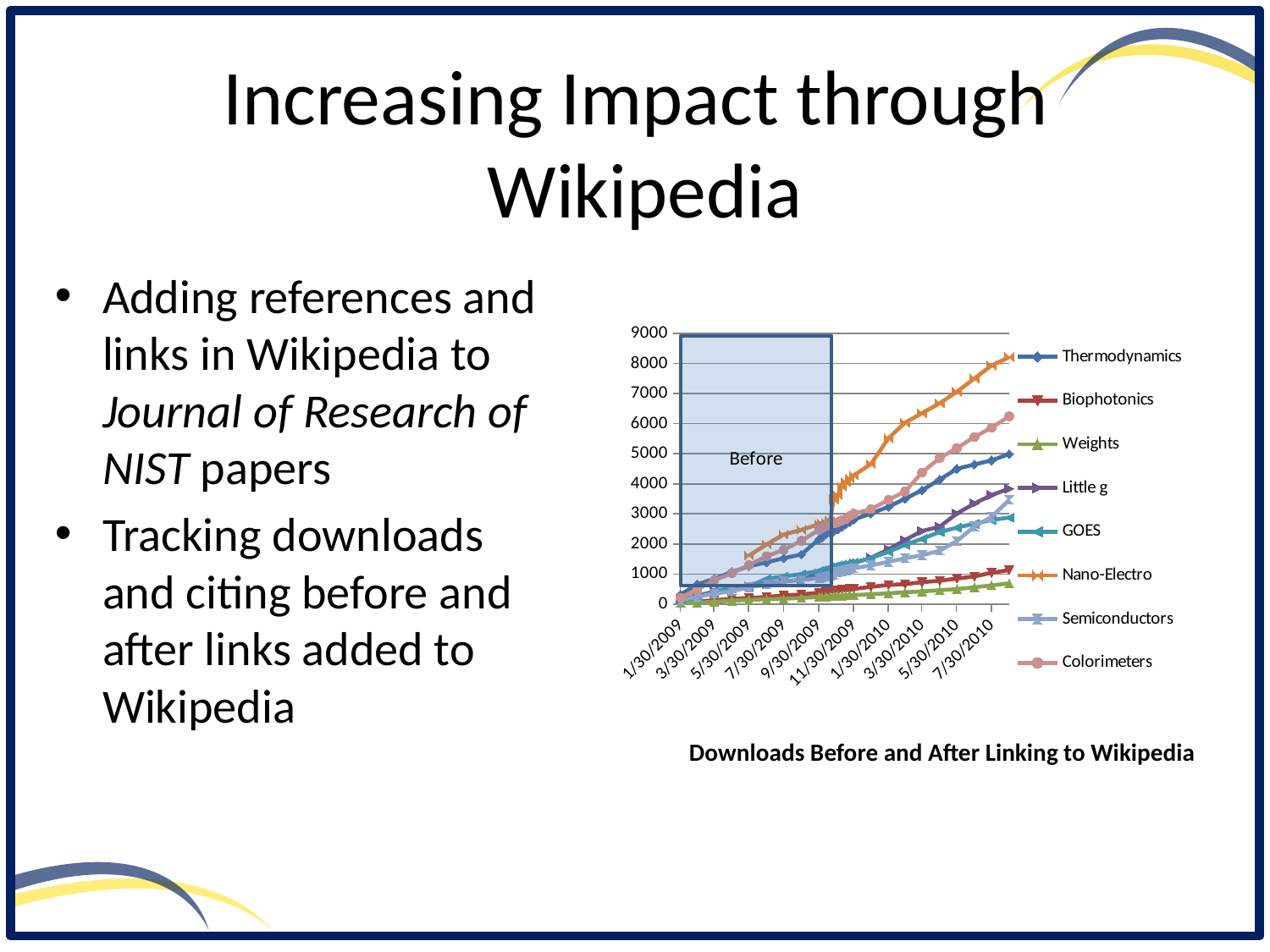
How many series does the chart legend list? 8 What kind of chart is shown on the slide? Line chart Which series has the highest value at the end of the period (7/30/2010)? Nano-Electro What label is shown inside the shaded region on the left of the chart? Before Is the final value for Nano-Electro greater or less than 8000? greater Which series has the lowest value at the end of the period (7/30/2010)? Weights Is the final value for Weights greater or less than 1000? less At the end of the period, which is larger: Nano-Electro or Thermodynamics? Nano-Electro Is the final value for Colorimeters greater or less than 5000? greater Do the download values generally rise or fall over time along the x axis? Rise What is the title of the chart? Downloads Before and After Linking to Wikipedia